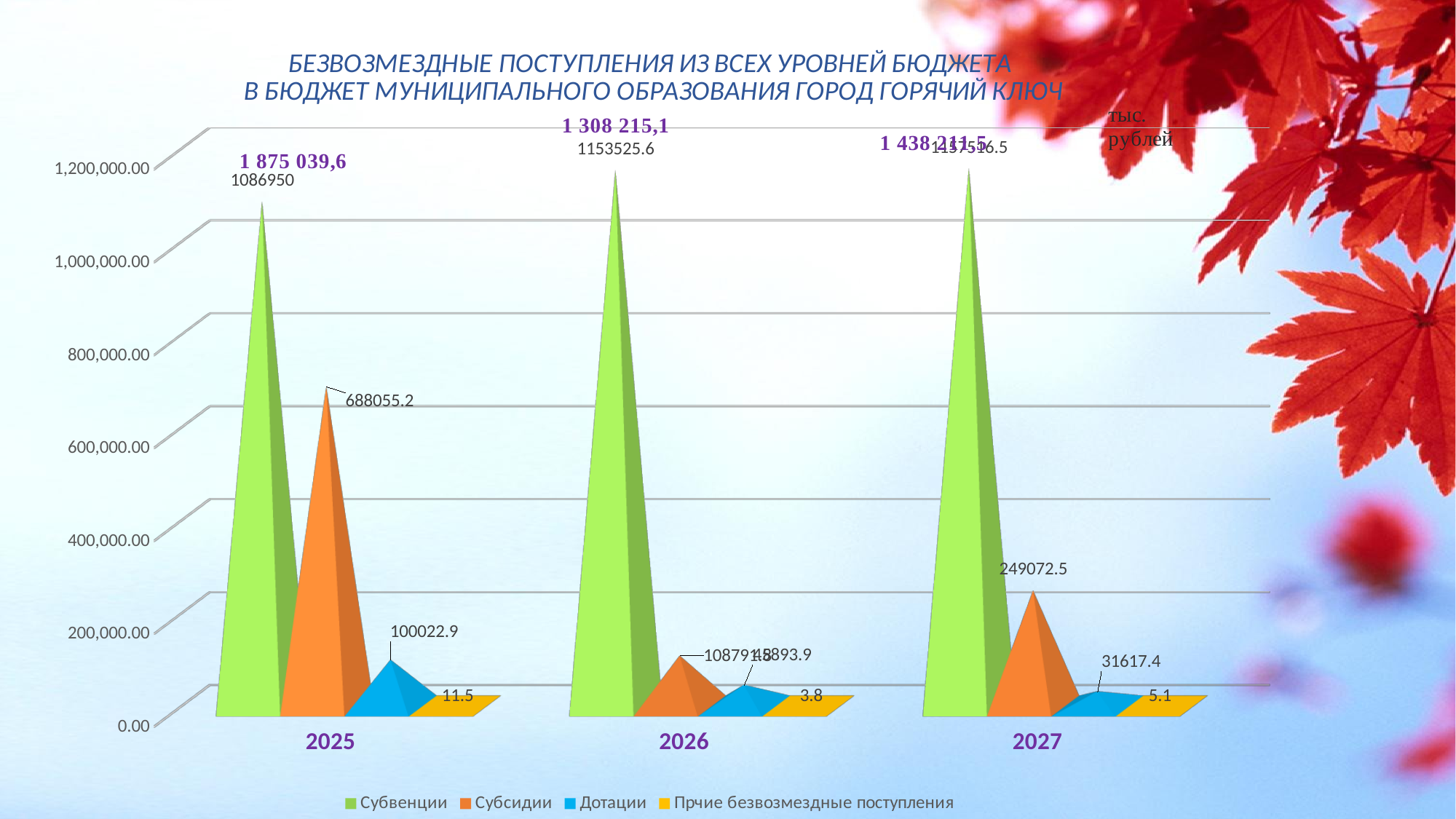
What is the value of Субвенции for 2025? 1086950 Is the value of Субсидии for 2027 greater or less than 400,000.00? less What is the value of Дотации for 2027? 31617.4 What is the difference between Субвенции and Субсидии in 2025? 398894.8 How many year categories are shown on the x axis? 3 What type of chart is shown on the slide? bar chart What is the value of Субсидии for 2027? 249072.5 What is the value of Субвенции for 2026? 1153525.6 How many series does the legend list? 4 What is the value of Дотации for 2025? 100022.9 What is the value of Субсидии for 2025? 688055.2 Which series has the lowest value in 2026? Прчие безвозмездные поступления